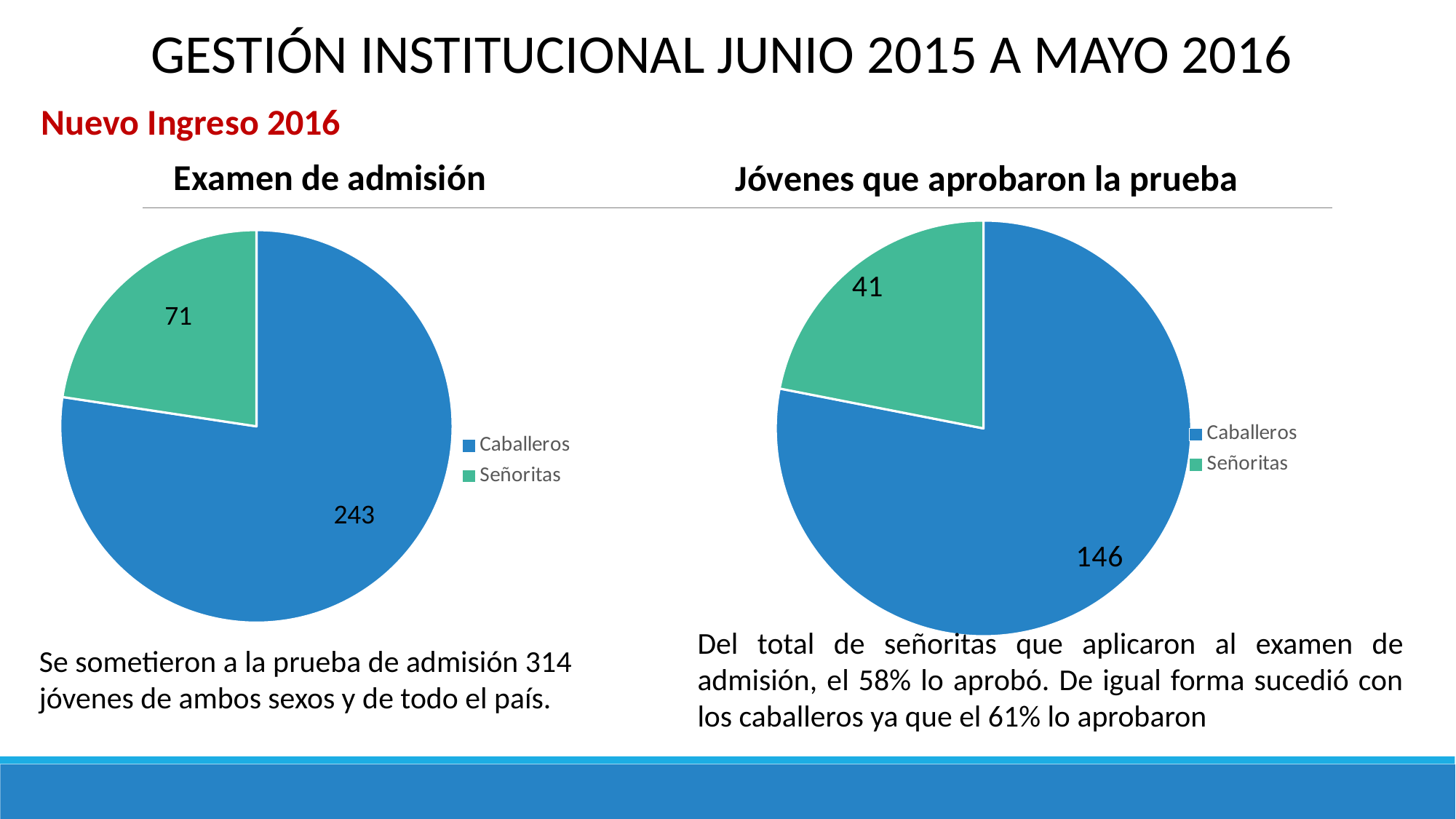
In the 'Examen de admisión' chart, what is the value for Caballeros? 243 In the 'Jóvenes que aprobaron la prueba' chart, what is the value for Caballeros? 146 Which is larger: the Señoritas value in the 'Examen de admisión' chart or the Señoritas value in the 'Jóvenes que aprobaron la prueba' chart? Examen de admisión In the 'Jóvenes que aprobaron la prueba' chart, what is the difference between the Caballeros and Señoritas values? 105 In the 'Jóvenes que aprobaron la prueba' chart, which category has the smallest slice? Señoritas In the 'Examen de admisión' chart, which category has the largest slice? Caballeros In the 'Examen de admisión' chart, what colour is the Señoritas slice? Green What type of chart is the 'Examen de admisión' chart? Pie chart In the 'Examen de admisión' chart, what is the difference between the Caballeros and Señoritas values? 172 In the 'Jóvenes que aprobaron la prueba' chart, what is the value for Señoritas? 41 How many categories does the legend of the 'Jóvenes que aprobaron la prueba' chart list? 2 In the 'Examen de admisión' chart, what is the value for Señoritas? 71